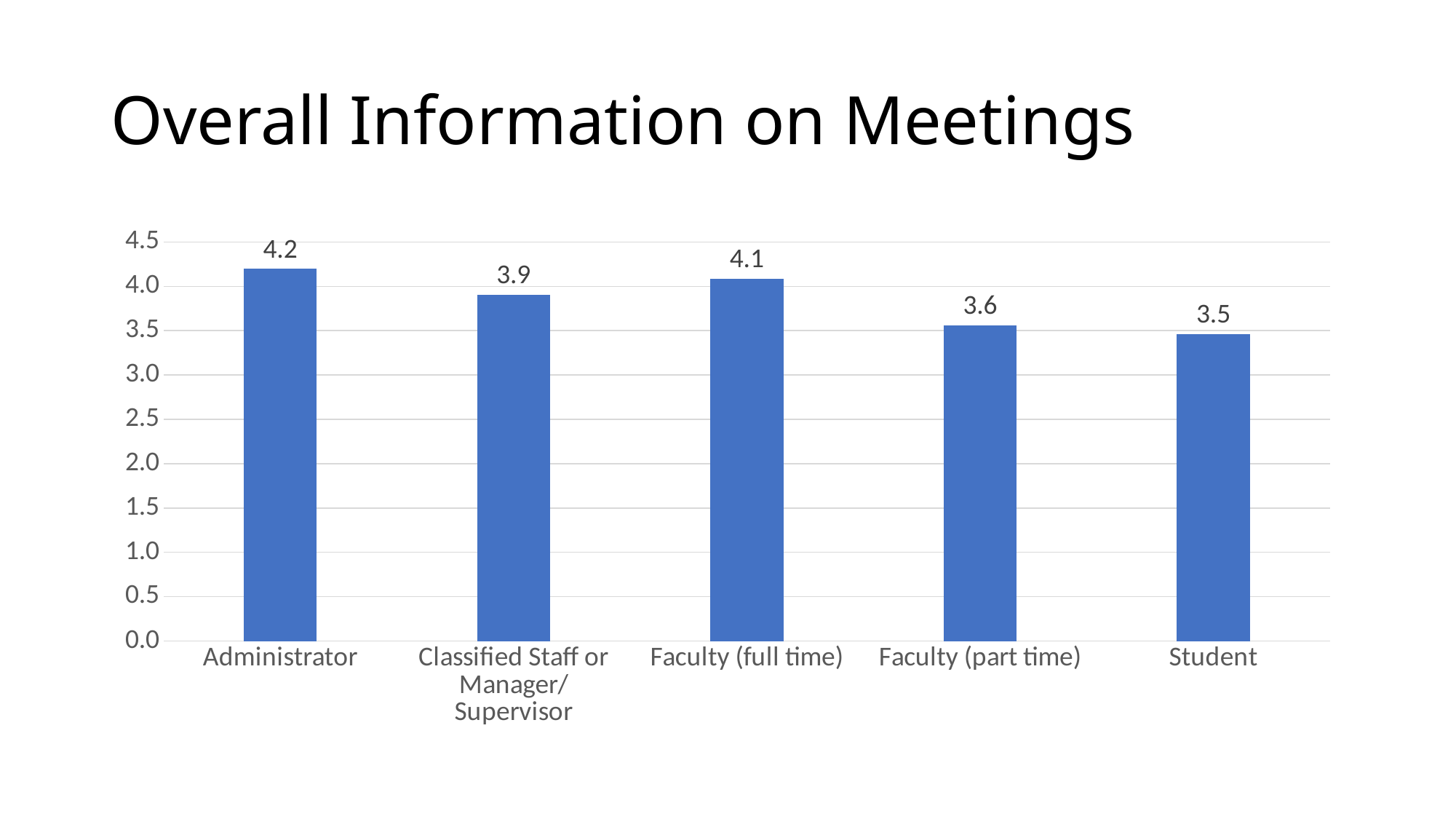
Which category has the highest value? Administrator Is the value for Faculty (part time) greater or less than 4.0? less What is the value for Classified Staff or Manager/Supervisor? 3.9 Which is larger, the value for Faculty (full time) or Faculty (part time)? Faculty (full time) How many categories are shown on the x axis? 5 What is the value for Administrator? 4.2 Which category has the lowest value? Student What is the value for Faculty (full time)? 4.1 What is the difference between the values for Administrator and Student? 0.7 What is the title of the slide? Overall Information on Meetings What kind of chart is shown on the slide? bar chart What is the value for Student? 3.5